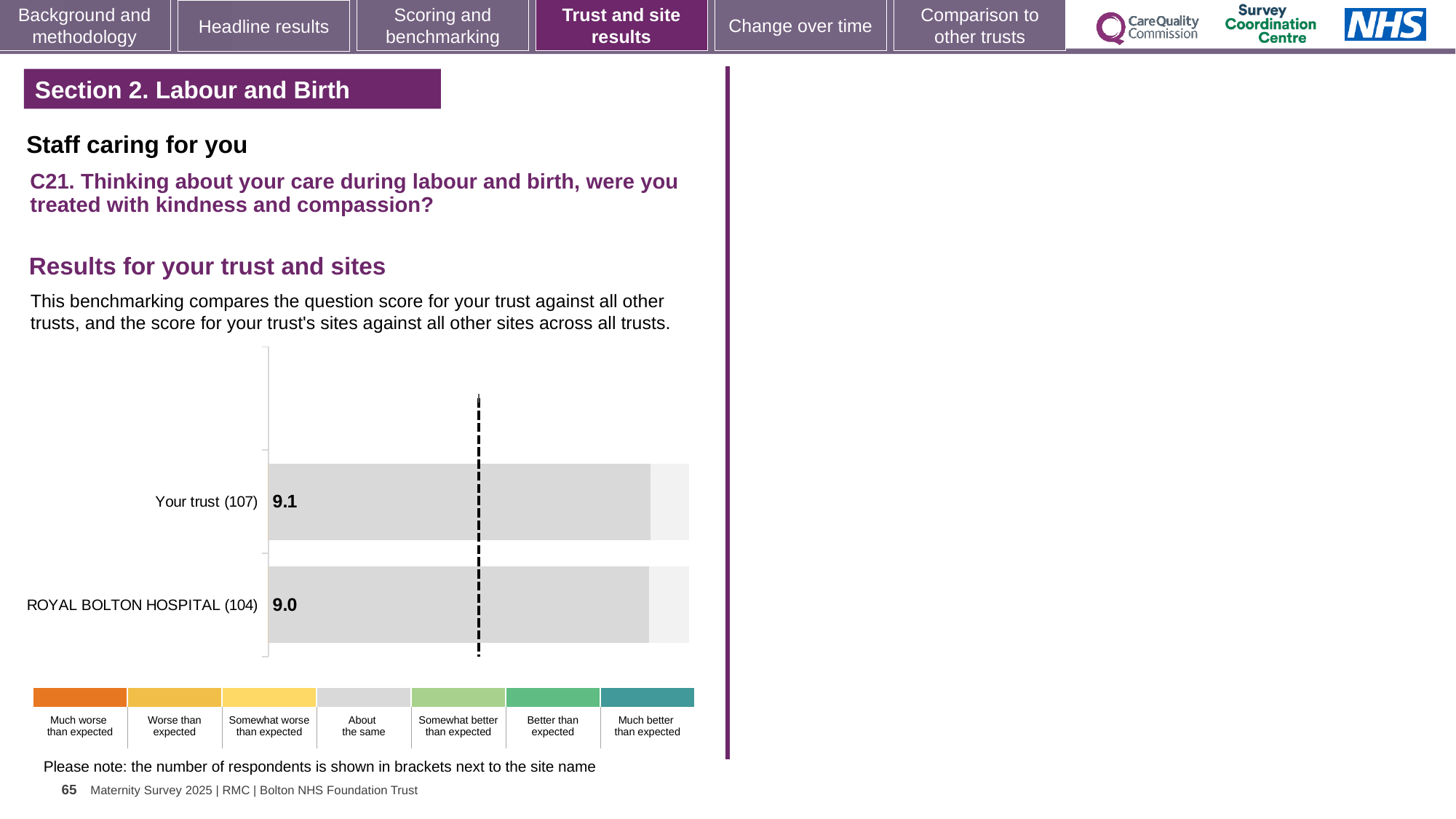
What is the difference between the score for Your trust and the score for ROYAL BOLTON HOSPITAL? 0.1 Which category of the colour key does the grey colour of the bars correspond to? About the same How many bars are plotted in the chart? 2 How many respondents are shown in brackets for Your trust? 107 Which bar has the lower score, Your trust or ROYAL BOLTON HOSPITAL? ROYAL BOLTON HOSPITAL What is the score for ROYAL BOLTON HOSPITAL (104)? 9.0 How many respondents are shown in brackets for ROYAL BOLTON HOSPITAL? 104 Is the score for Your trust larger or smaller than the score for ROYAL BOLTON HOSPITAL? larger How many categories does the colour key below the chart list? 7 Which bar has the higher score, Your trust or ROYAL BOLTON HOSPITAL? Your trust What is the score for Your trust (107)? 9.1 What kind of chart is shown on the slide? bar chart